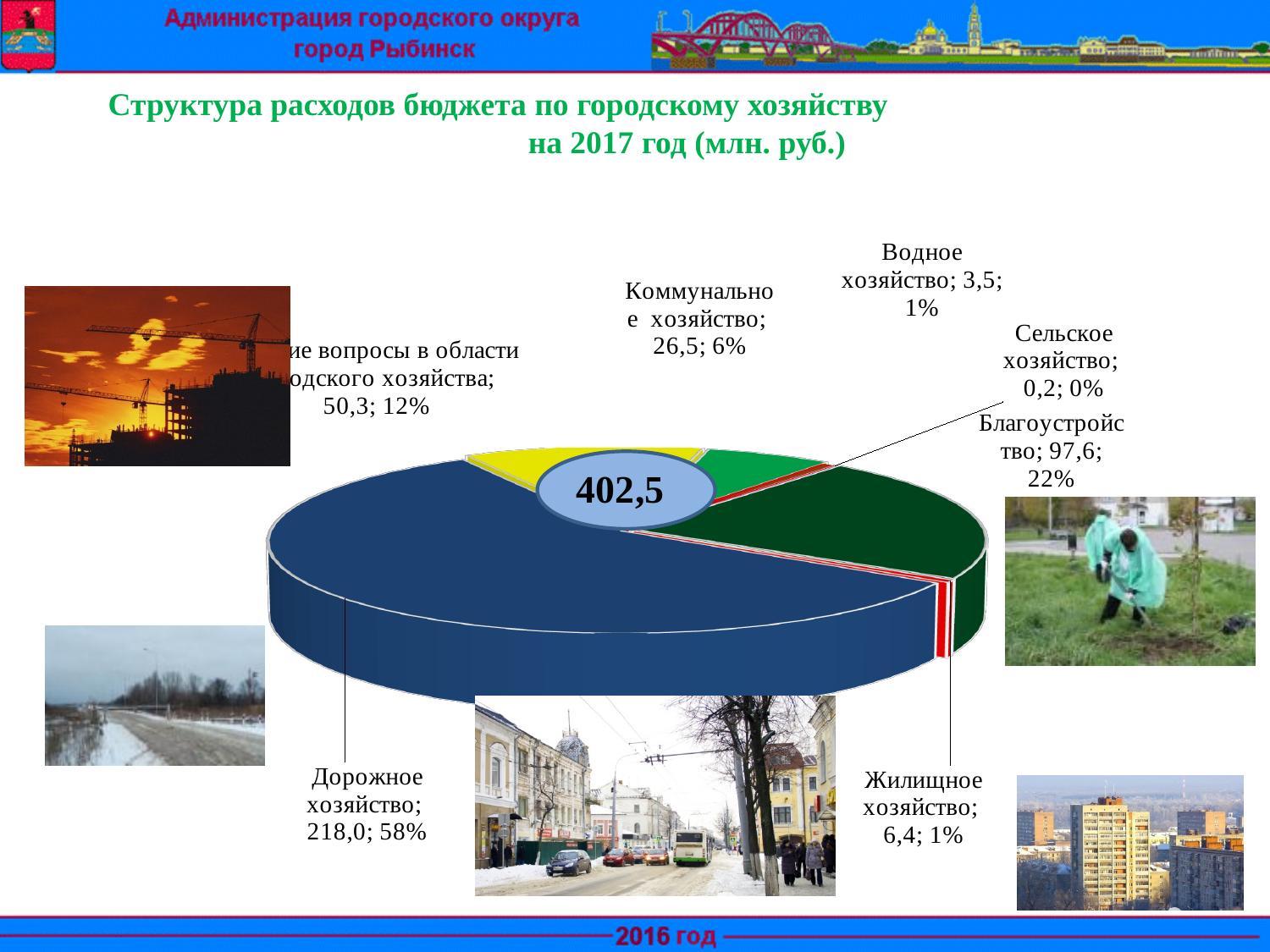
Which category has the smallest value? Сельское хозяйство What is the value for Благоустройство? 97,6 What share of the pie does Благоустройство take? 22% What is the value for Коммунальное хозяйство? 26,5 What kind of chart is shown on the slide? pie chart Which category has the largest value? Дорожное хозяйство What is the value for Дорожное хозяйство? 218,0 What share of the pie does Дорожное хозяйство take? 58% What total value is shown in the centre of the pie chart? 402,5 What is the difference between the values for Дорожное хозяйство and Благоустройство? 120,4 What is the value for Жилищное хозяйство? 6,4 What is the value for Водное хозяйство? 3,5